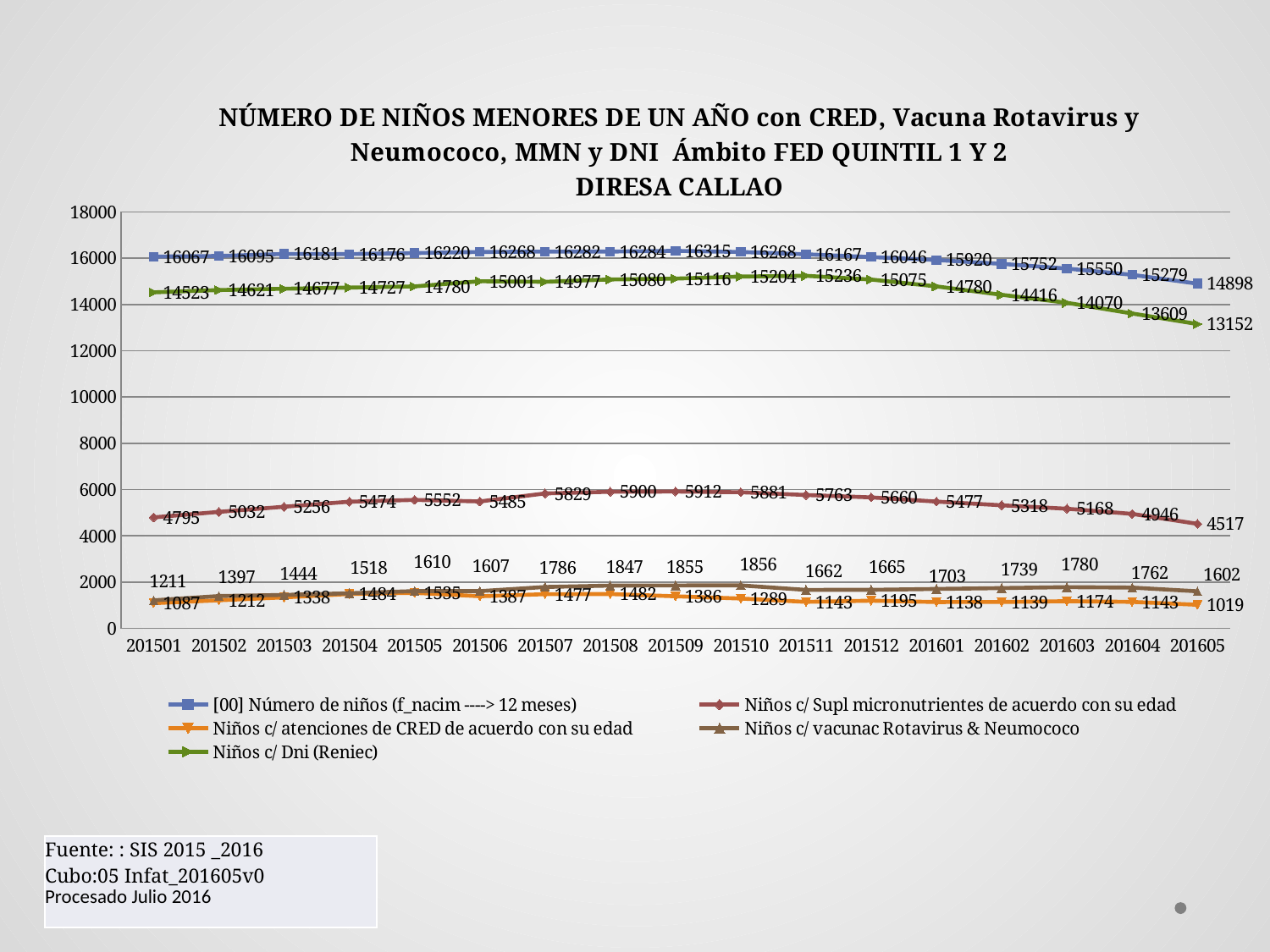
How many periods are shown on the x axis? 17 What is the value of the series '[00] Número de niños (f_nacim ----> 12 meses)' at 201605? 14898 What is the difference between the '[00] Número de niños' values at 201501 and 201605? 1169 How many series does the legend list? 5 What kind of chart is shown on the slide? line chart Is the value of 'Niños c/ Supl micronutrientes de acuerdo con su edad' at 201508 greater or less than 6000? less Does 'Niños c/ Dni (Reniec)' rise or fall from 201511 to 201605? fall What is the value of 'Niños c/ atenciones de CRED de acuerdo con su edad' at 201505? 1535 What is the value of 'Niños c/ Dni (Reniec)' at 201511? 15236 In which period does 'Niños c/ Supl micronutrientes de acuerdo con su edad' reach its highest value? 201509 In which period does 'Niños c/ Dni (Reniec)' reach its lowest value? 201605 Which is larger for 'Niños c/ vacunac Rotavirus & Neumococo': the value at 201501 or at 201605? 201605